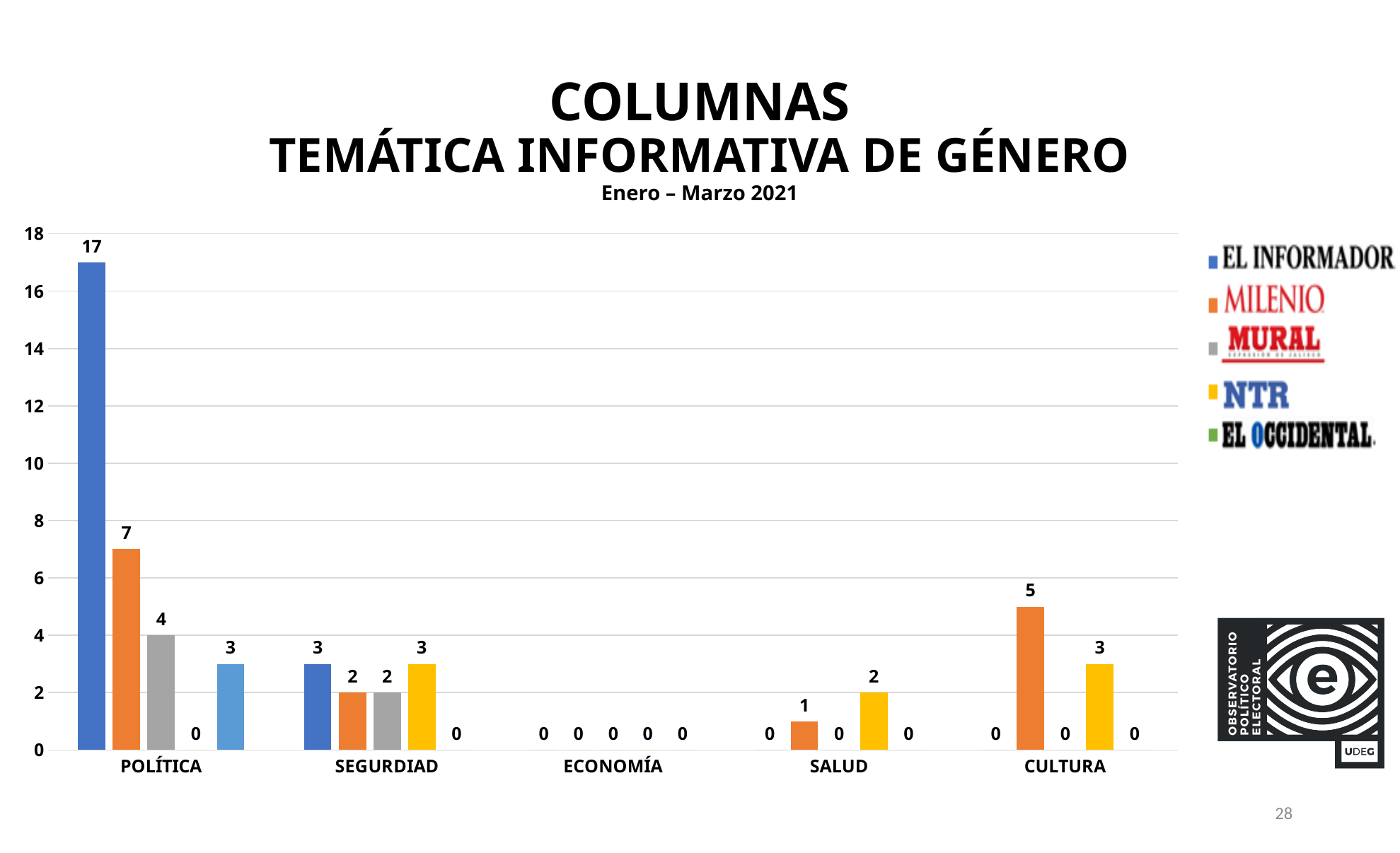
How many categories are shown on the x axis? 5 How many series does the legend list? 5 What is the value for MILENIO in the CULTURA category? 5 What is the value for NTR in the SALUD category? 2 In which category does EL INFORMADOR have its highest value? POLÍTICA What is the value for MILENIO in the SALUD category? 1 What is the value for MURAL in the SEGURDIAD category? 2 Is the MILENIO value larger in POLÍTICA or in CULTURA? POLÍTICA What period does the chart cover, according to the subtitle? Enero – Marzo 2021 What is the value for EL INFORMADOR in the POLÍTICA category? 17 What is the difference between the EL INFORMADOR and MILENIO values in the POLÍTICA category? 10 What kind of chart is shown on the slide? Bar chart